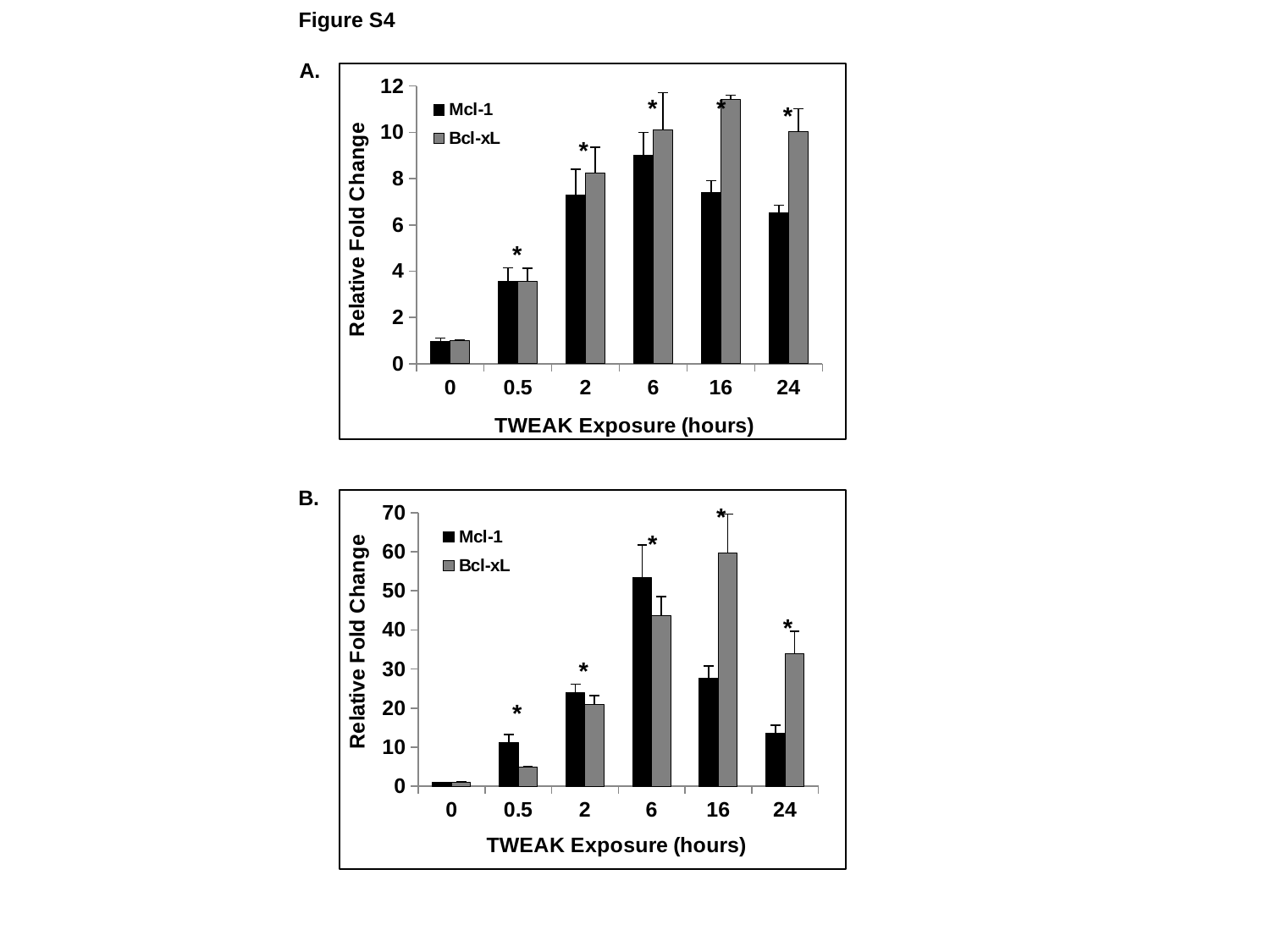
In chart B (bottom), what is the title of the x axis? TWEAK Exposure (hours) In chart A (top), how many series does the legend list? 2 In chart B (bottom), at which TWEAK exposure time is the Mcl-1 bar highest? 6 In chart A (top), at which TWEAK exposure time is the Bcl-xL bar highest? 16 In chart A (top), what kind of chart is shown? bar chart In chart A (top), at which TWEAK exposure time is the Mcl-1 bar highest? 6 In chart A (top), how many TWEAK exposure time points are shown on the x axis? 6 In chart A (top), at 24 hours, which series has the larger value, Mcl-1 or Bcl-xL? Bcl-xL In chart B (bottom), is the Mcl-1 value at 6 hours greater or less than 50? greater In chart A (top), is the Bcl-xL value at 16 hours greater or less than 10? greater In chart B (bottom), at 0.5 hours, which series has the larger value, Mcl-1 or Bcl-xL? Mcl-1